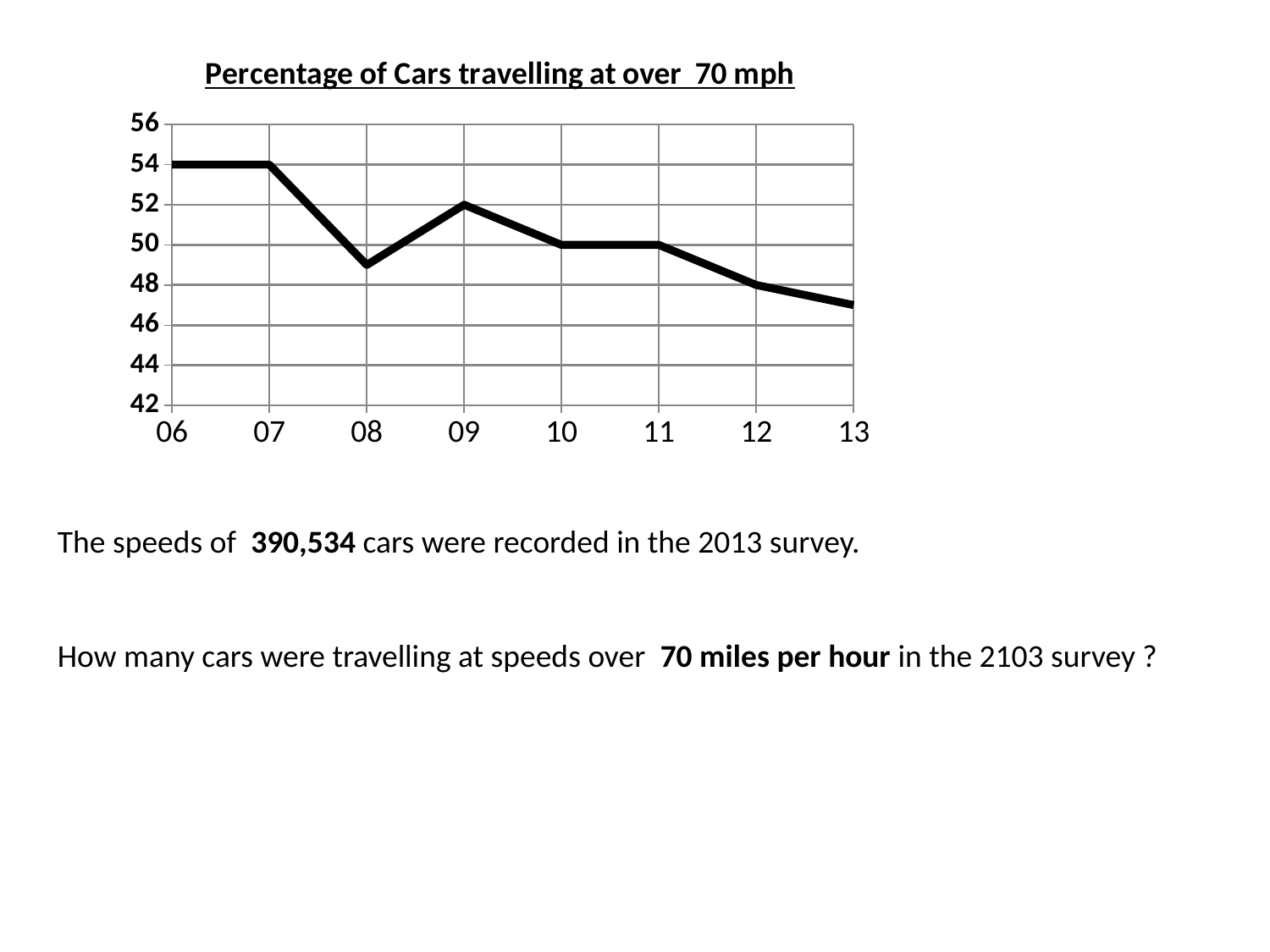
What is the percentage of cars travelling at over 70 mph in 06? 54 What kind of chart is shown on the slide? line chart Is the value for 13 greater or less than 48? less How many years are plotted on the x axis of the chart? 8 What is the percentage of cars travelling at over 70 mph in 12? 48 Is the value for 08 greater or less than 50? less What is the percentage of cars travelling at over 70 mph in 11? 50 Overall, do the values rise or fall from 06 to 13? fall What is the percentage of cars travelling at over 70 mph in 09? 52 What is the title of the chart? Percentage of Cars travelling at over 70 mph What is the difference between the values for 06 and 12? 6 Which year has the lowest percentage of cars travelling at over 70 mph? 13